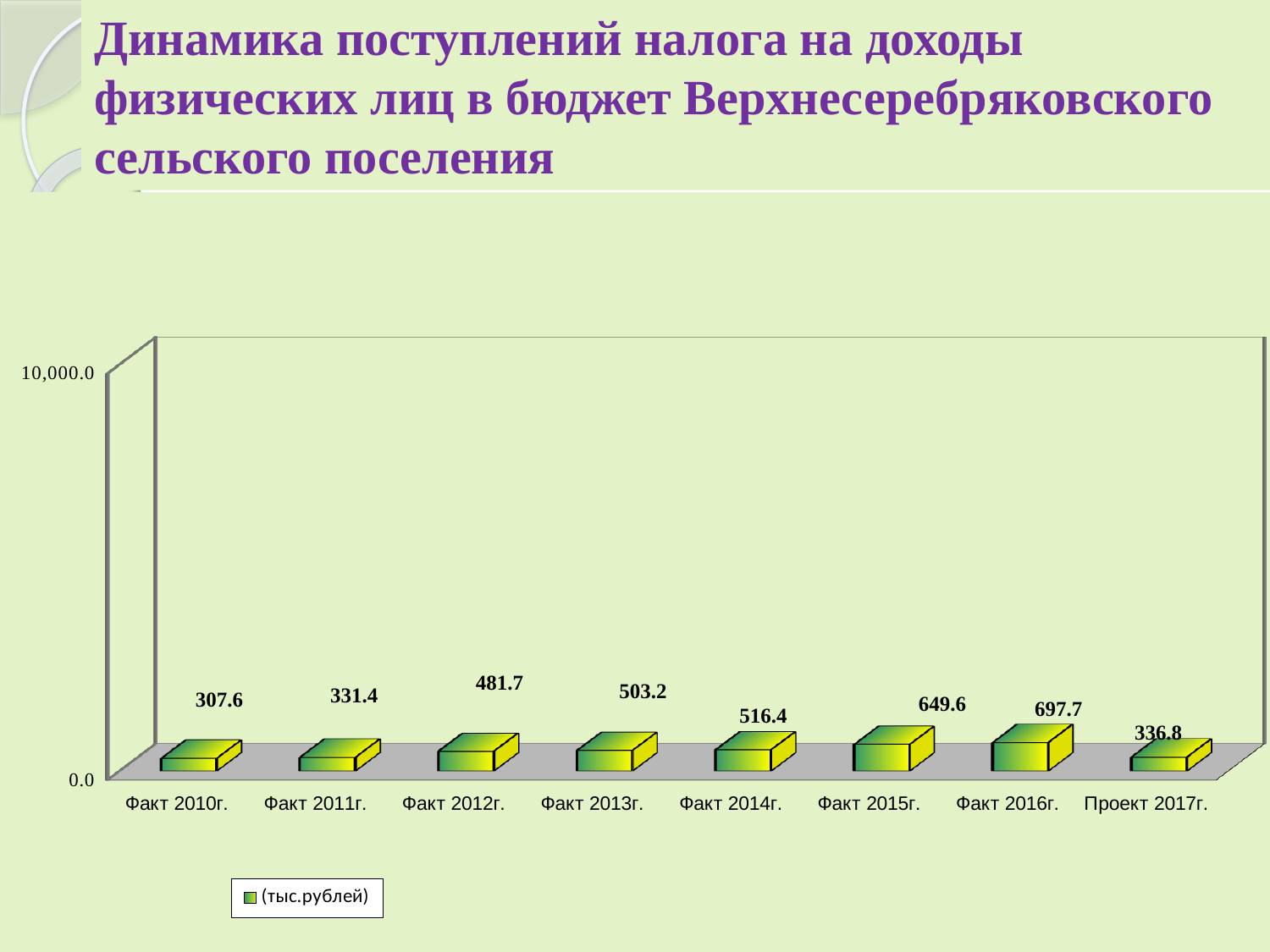
What is the value for Факт 2012г.? 481.7 What is the difference between the values for Факт 2016г. and Факт 2015г.? 48.1 Which category has the lowest value? Факт 2010г. What is the value for Факт 2015г.? 649.6 Do the values rise or fall from Факт 2010г. to Факт 2016г.? rise How many categories are shown on the x axis? 8 How many series does the legend list? 1 Which category has the highest value? Факт 2016г. What kind of chart is shown on the slide? bar chart Which is larger, the value for Факт 2013г. or Факт 2014г.? Факт 2014г. What is the value for Проект 2017г.? 336.8 What unit does the legend entry give for the series? (тыс.рублей)